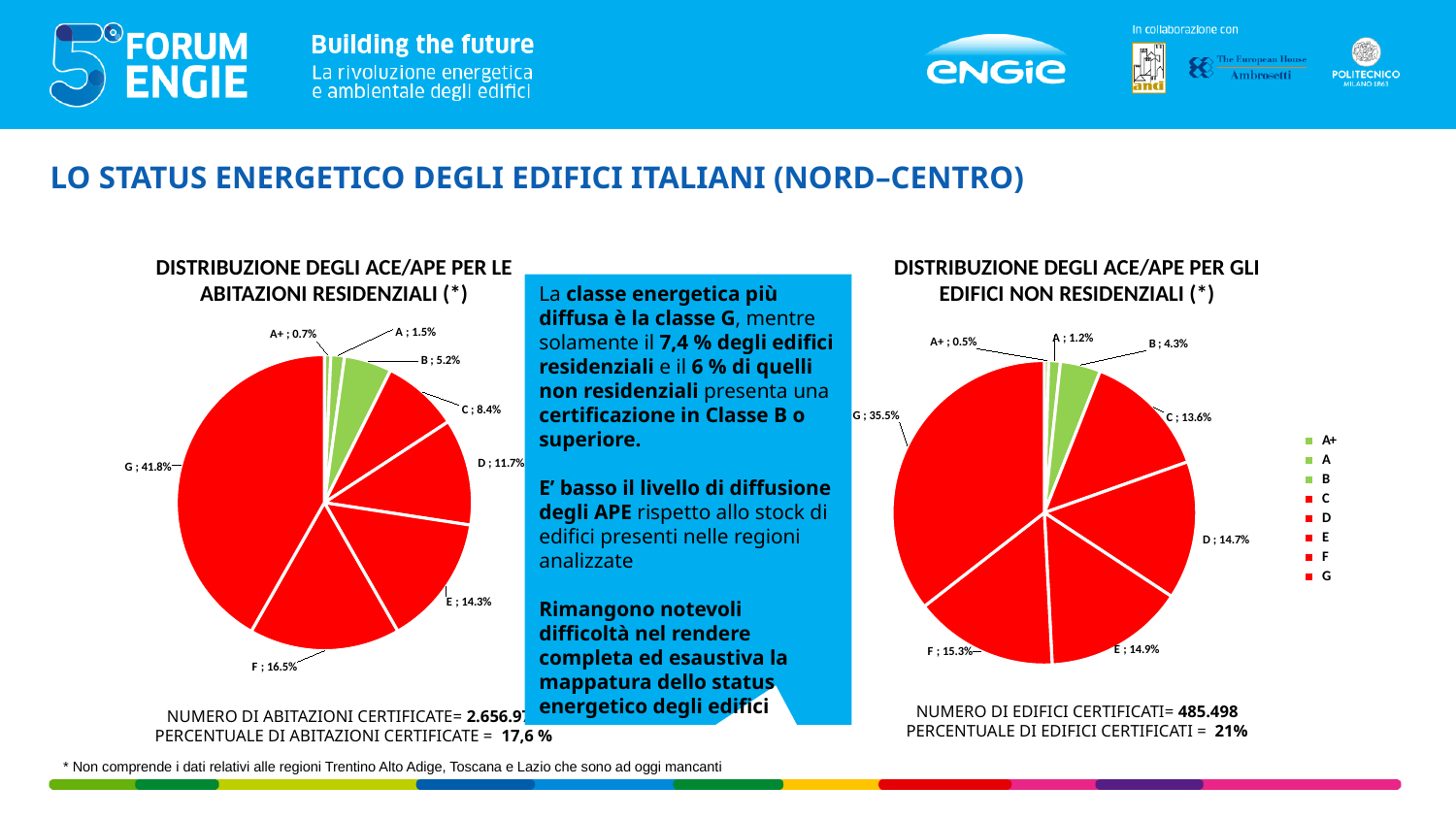
In the non-residential pie chart (right), which is larger: the share of class D or the share of class B? D In the residential pie chart (left), which class has the largest share? G What type of chart is used for the distribution of ACE/APE for residential dwellings (left)? Pie chart What is the title of the chart on the right? DISTRIBUZIONE DEGLI ACE/APE PER GLI EDIFICI NON RESIDENZIALI (*) How many entries does the legend of the non-residential pie chart (right) list? 8 How many slices does the residential pie chart (left) have? 8 In the residential pie chart (left), what is the difference between the shares of class F and class E? 2.2% In the residential pie chart (left), what share does class G have? 41.8% In the non-residential pie chart (right), which class has the smallest share? A+ In the residential pie chart (left), what share does class A+ have? 0.7% In the non-residential pie chart (right), what is the combined share of classes A+, A and B? 6% In the non-residential pie chart (right), what share does class C have? 13.6%